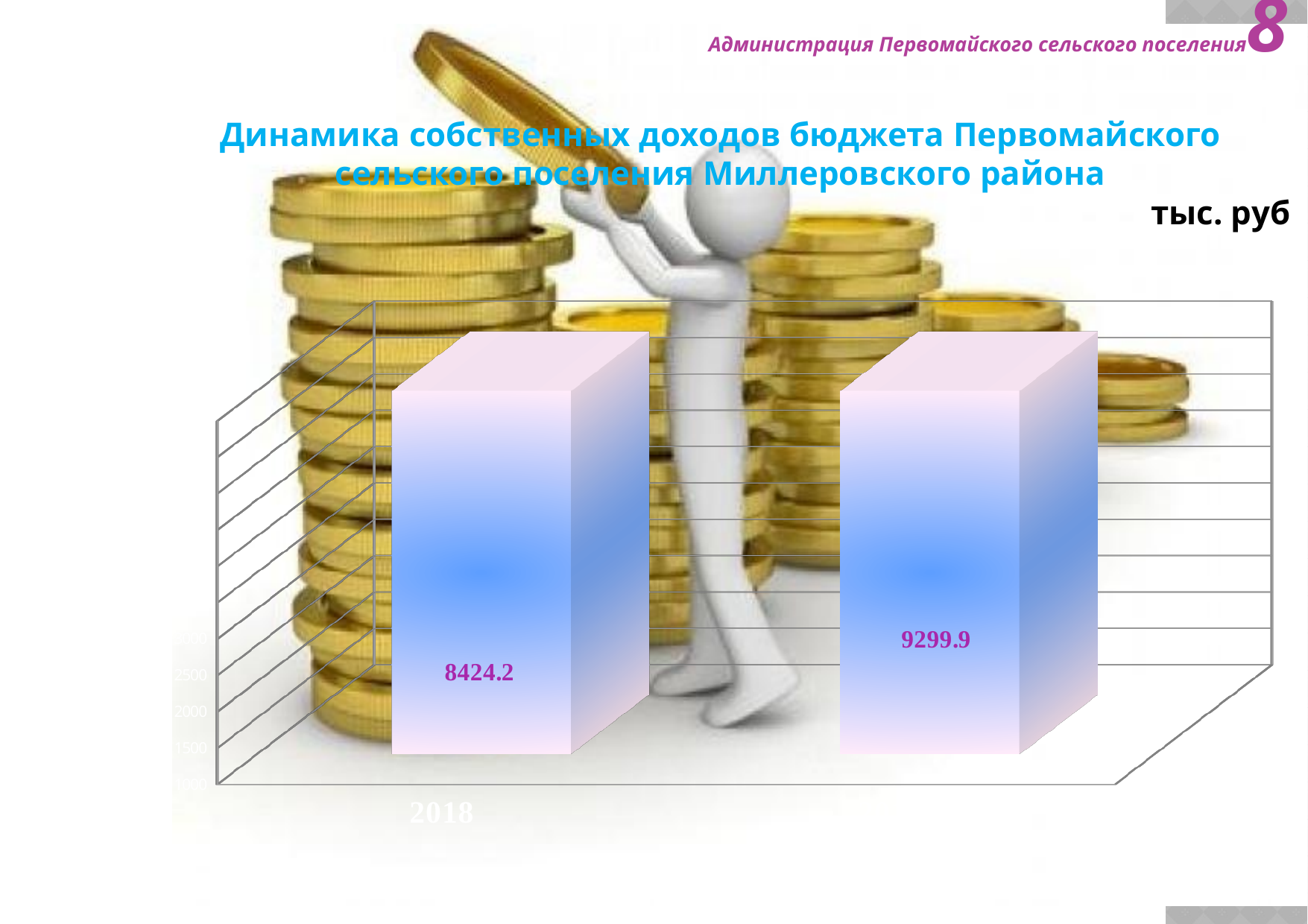
Which bar is the tallest in the chart? The right-hand bar (9299.9) What is the difference between the right-hand bar's value and the 2018 value? 875.7 What is the title of the chart? Динамика собственных доходов бюджета Первомайского сельского поселения Миллеровского района Do the values rise or fall from the left bar to the right bar? Rise What kind of chart is shown on the slide? Bar chart What value is printed on the right-hand bar of the chart? 9299.9 In what units are the chart values given, according to the slide? тыс. руб Which bar has the lowest value in the chart? 2018 (8424.2) Which is larger: the value for 2018 or the value on the right-hand bar? The right-hand bar What is the value of the bar for 2018? 8424.2 How many bars are plotted in the chart? 2